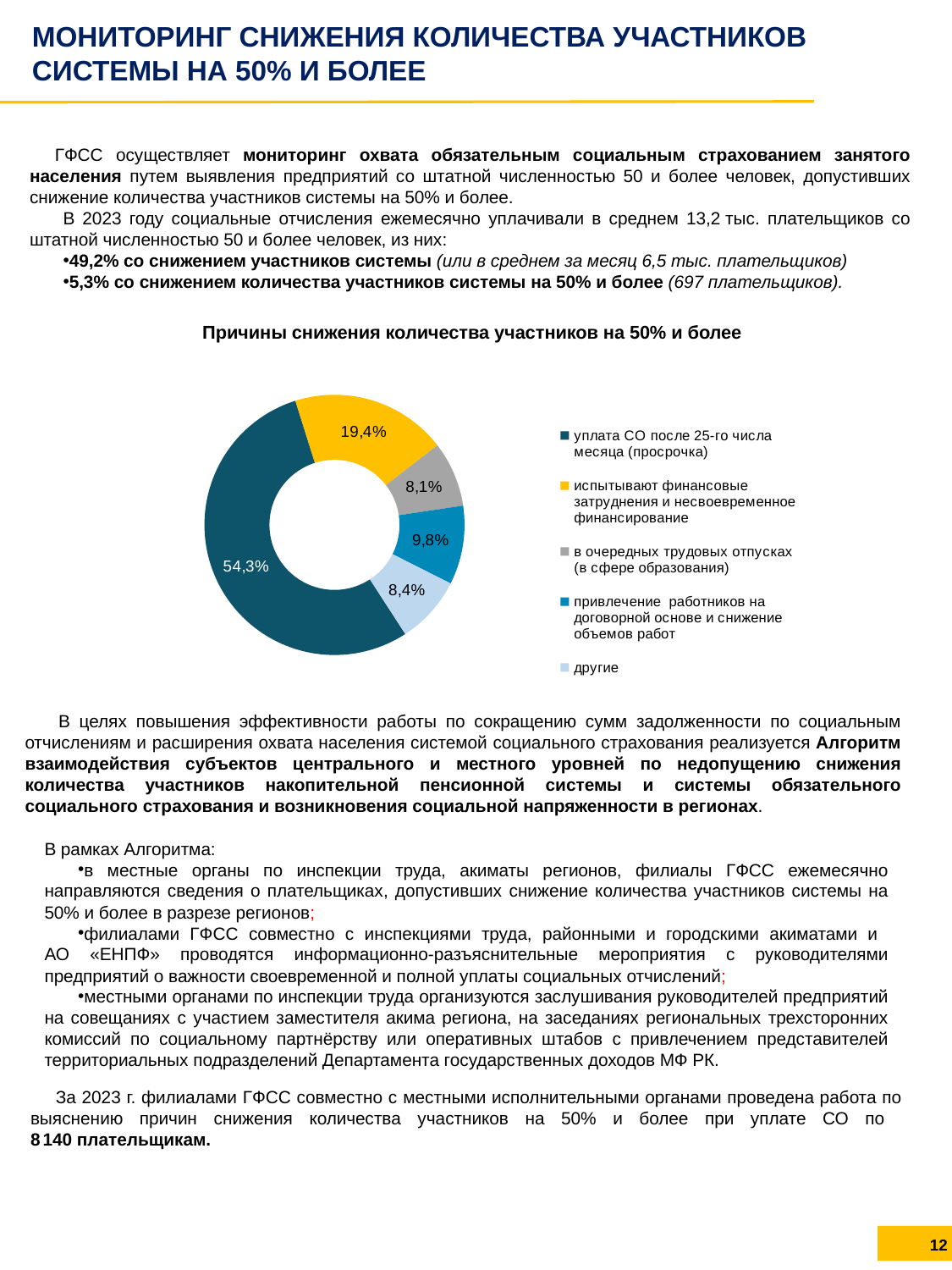
Which is larger: the share for 'привлечение работников на договорной основе и снижение объемов работ' or the share for 'другие'? привлечение работников на договорной основе и снижение объемов работ What type of chart is shown on the slide? Pie (donut) chart How many entries does the legend list? 5 What is the title of the chart? Причины снижения количества участников на 50% и более What share of the chart is 'уплата СО после 25-го числа месяца (просрочка)'? 54,3% What share of the chart is 'другие'? 8,4% Which category has the largest share in the chart? уплата СО после 25-го числа месяца (просрочка) What share of the chart is 'испытывают финансовые затруднения и несвоевременное финансирование'? 19,4% What is the difference between the share for 'уплата СО после 25-го числа месяца (просрочка)' and the share for 'испытывают финансовые затруднения и несвоевременное финансирование'? 34,9% How many slices does the chart have? 5 What share of the chart is 'в очередных трудовых отпусках (в сфере образования)'? 8,1% Which category has the smallest share in the chart? в очередных трудовых отпусках (в сфере образования)